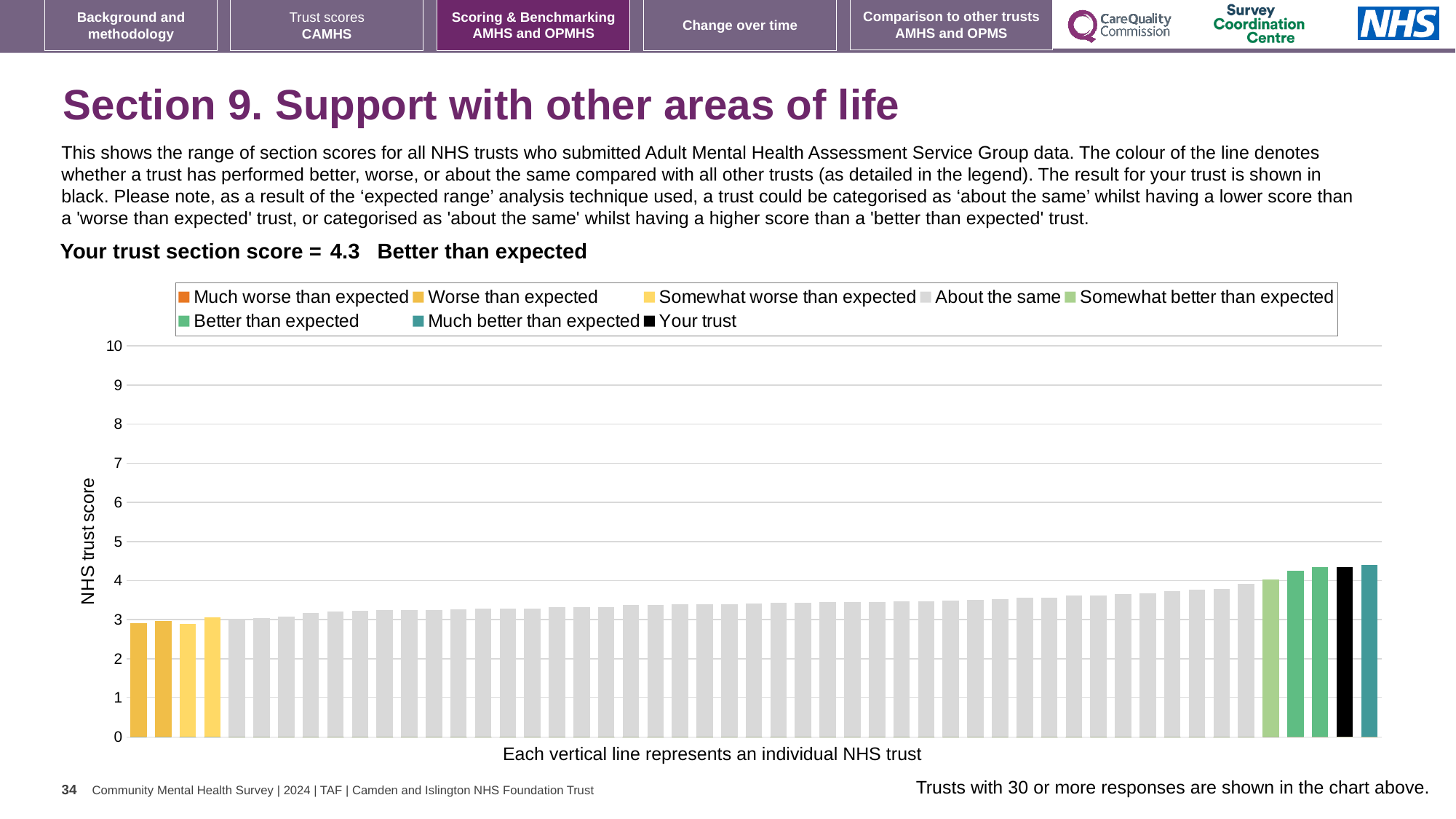
Is the value for the tallest bar greater or less than 5? less How many entries does the chart legend list? 8 What kind of chart is shown on the slide? bar chart Which category does your trust's section score of 4.3 fall into, according to the slide? Better than expected Is the value for your trust greater or less than 4? greater What is the section score for your trust shown on the slide? 4.3 Do the bar values rise or fall from left to right along the x axis? rise What is the label on the vertical axis of the chart? NHS trust score How many bars are coloured black (Your trust)? 1 Which is larger, the value for your trust or the value for the leftmost bar? your trust Which legend category does the tallest bar in the chart belong to? Much better than expected Is the value for the leftmost bar greater or less than 4? less